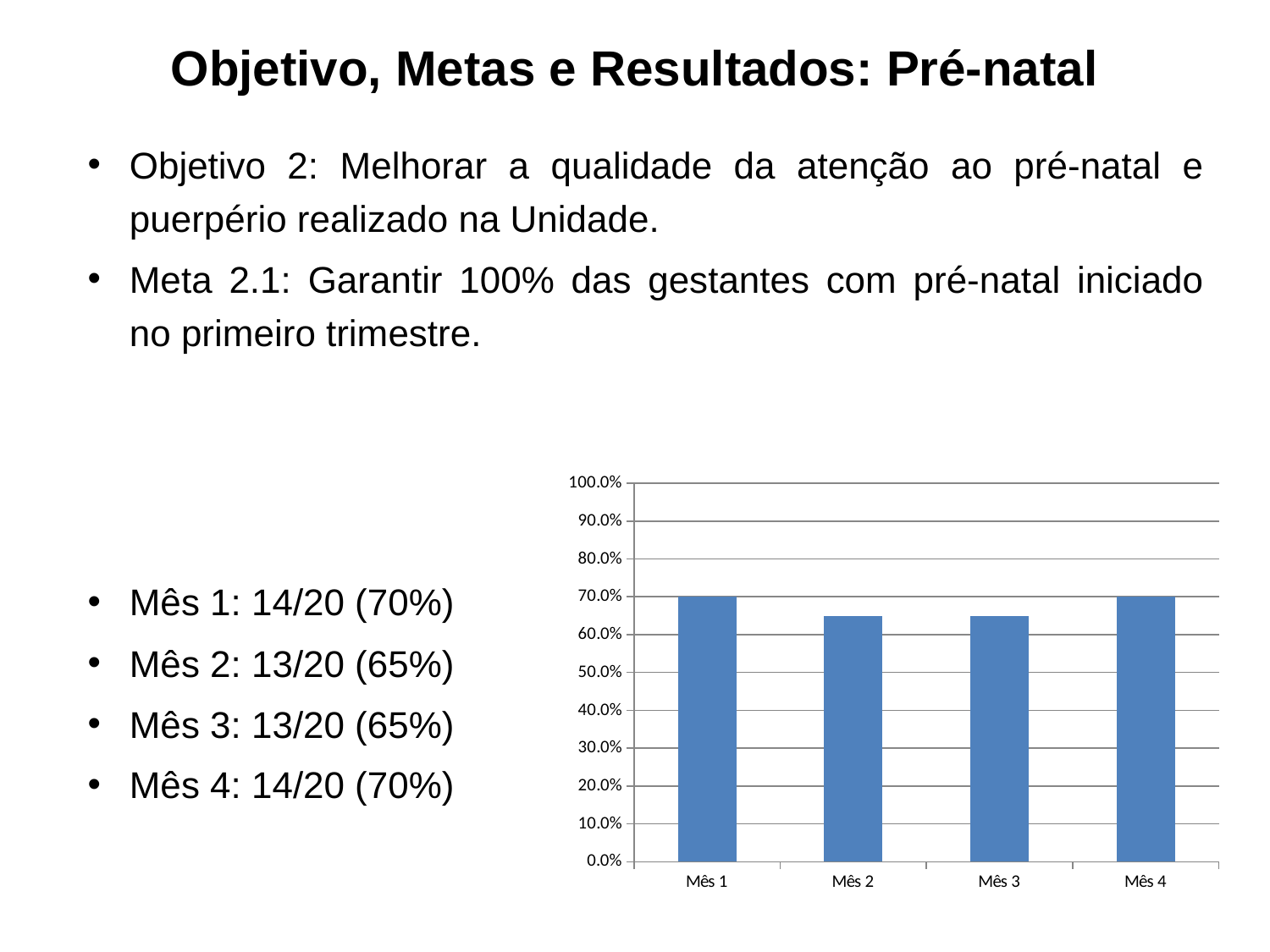
Is the value for Mês 2 greater or less than 60.0%? greater What is the highest value shown on the chart's vertical axis? 100.0% Is the value for Mês 1 greater or less than 80.0%? less What colour are the bars on the chart? blue What is the value for Mês 4 on the chart? 70.0% What kind of chart is shown on the slide? bar chart Does the value fall or rise from Mês 1 to Mês 2? fall Is the value for Mês 3 greater or less than 70.0%? less Which is larger, the value for Mês 3 or the value for Mês 4? Mês 4 Which is larger, the value for Mês 1 or the value for Mês 2? Mês 1 What is the value for Mês 1 on the chart? 70.0% How many categories (months) are plotted on the chart? 4